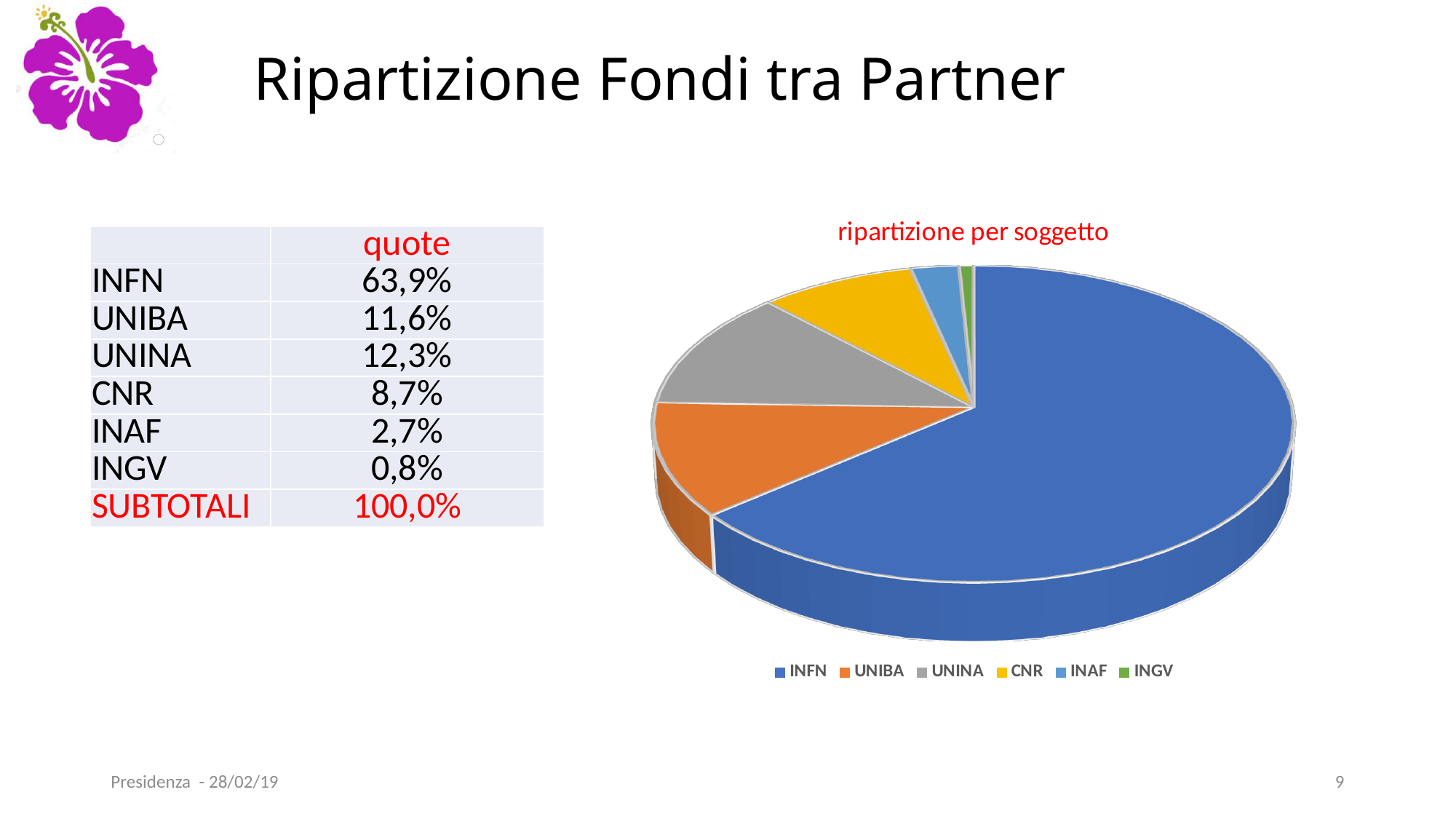
Which receives a larger share, CNR or INAF? CNR What is the difference between the shares of INFN and UNIBA? 52,3% Which partner receives the smallest share of the funds? INGV What is the title of the pie chart? ripartizione per soggetto Which partner receives the largest share of the funds? INFN How many partners (slices) are shown in the pie chart? 6 Which colour represents INFN in the pie chart? blue What kind of chart is shown on the slide? pie chart What share of the funds goes to CNR? 8,7% What share of the funds goes to UNINA? 12,3% What share of the funds goes to INGV? 0,8% What share of the funds goes to INFN? 63,9%